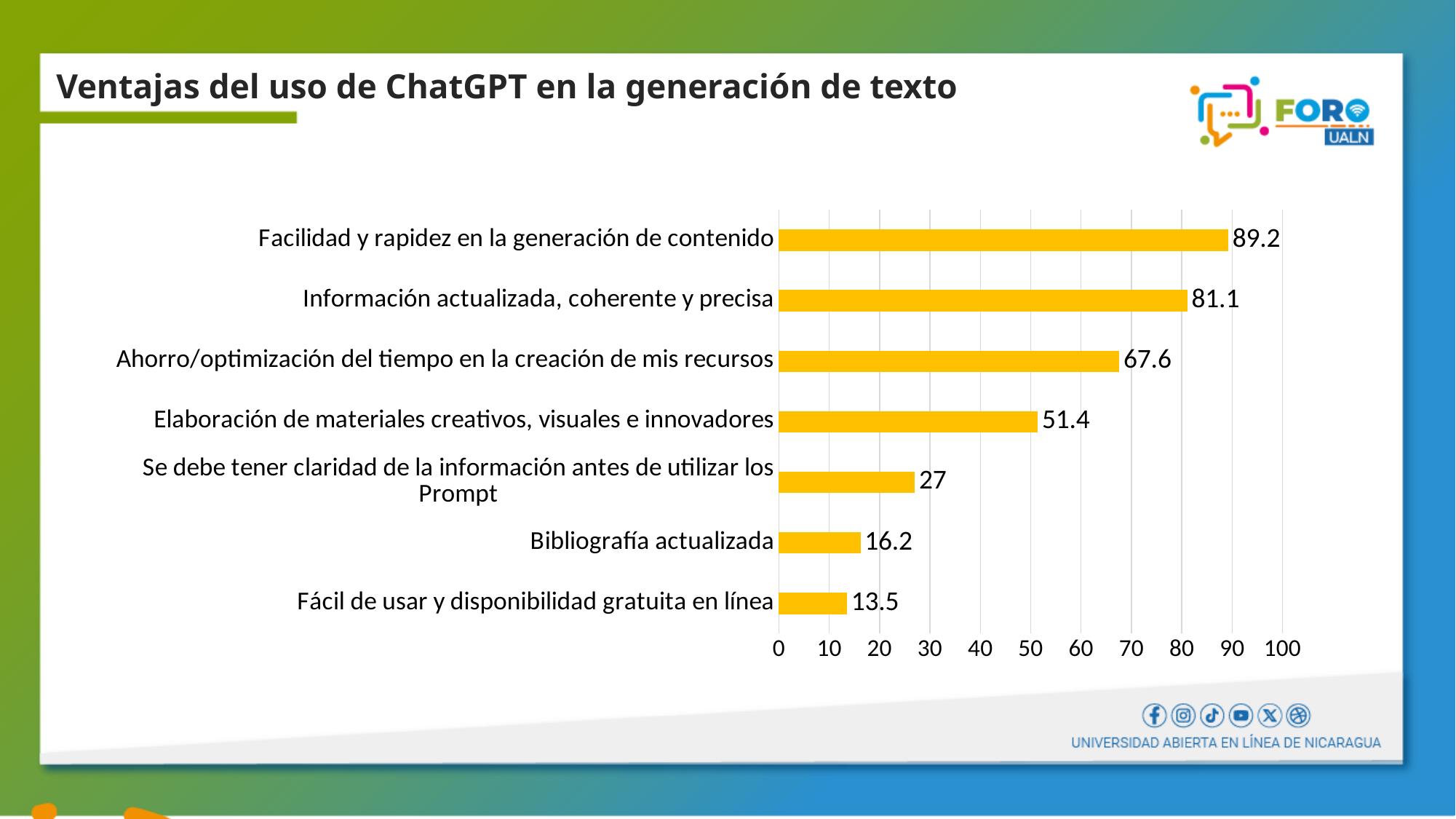
What is the value for "Bibliografía actualizada"? 16.2 What colour are the bars in the chart? Yellow Which is larger: the value for "Elaboración de materiales creativos, visuales e innovadores" or the value for "Bibliografía actualizada"? Elaboración de materiales creativos, visuales e innovadores How many categories are shown in the chart? 7 Is the value for "Ahorro/optimización del tiempo en la creación de mis recursos" greater or less than 60? greater What is the difference between the values for "Información actualizada, coherente y precisa" and "Ahorro/optimización del tiempo en la creación de mis recursos"? 13.5 What is the value for "Se debe tener claridad de la información antes de utilizar los Prompt"? 27 Which category has the highest value? Facilidad y rapidez en la generación de contenido What is the value for "Facilidad y rapidez en la generación de contenido"? 89.2 What is the title of the slide containing the chart? Ventajas del uso de ChatGPT en la generación de texto What kind of chart is shown on the slide? Bar chart Which category has the lowest value? Fácil de usar y disponibilidad gratuita en línea